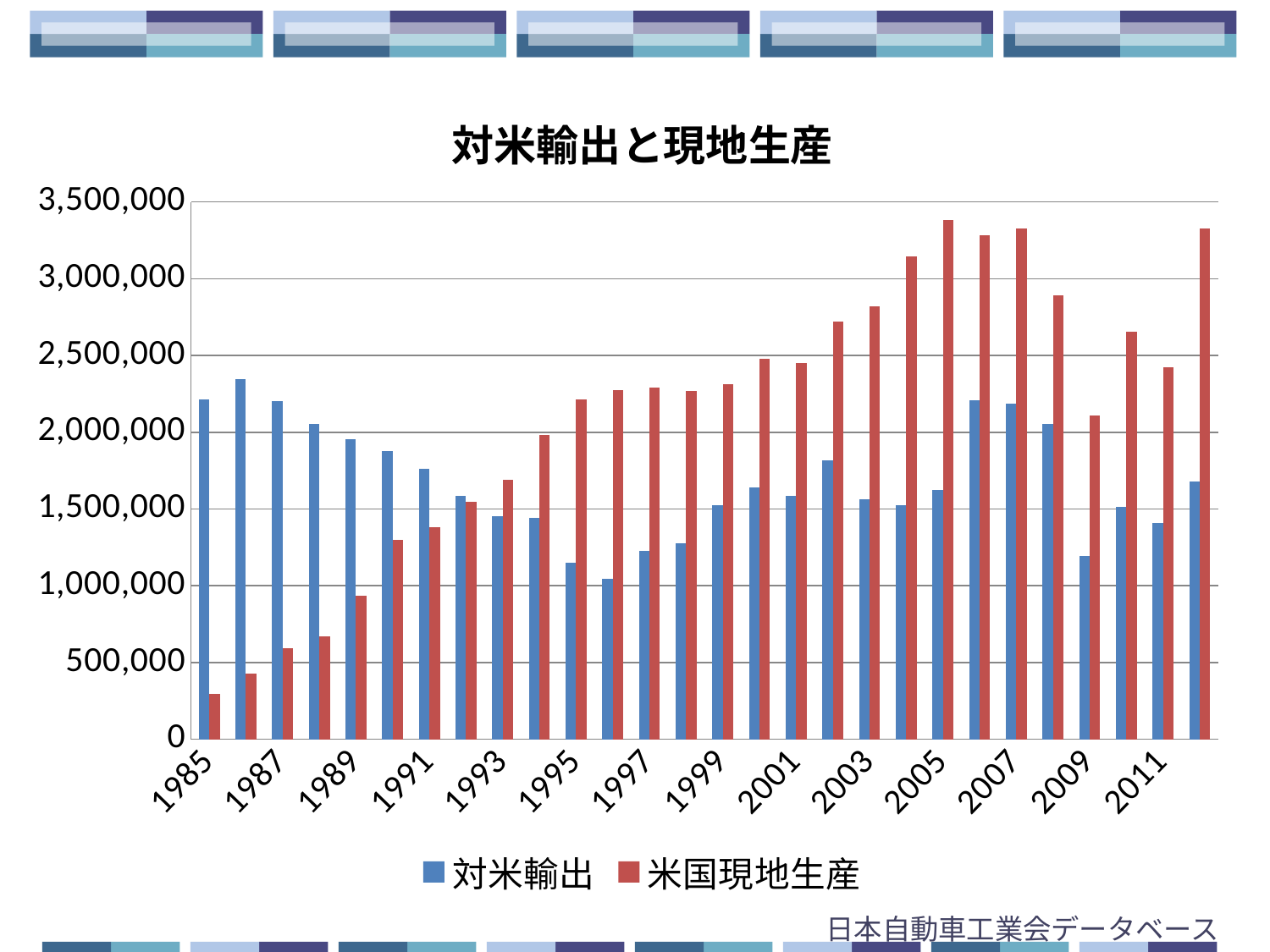
Is the value of 対米輸出 in 2009 greater or less than 1,500,000? less Does 米国現地生産 generally rise or fall from 1985 to 2005? rise Is the value of 米国現地生産 in 2005 greater or less than 3,000,000? greater In 2003, which is larger, 対米輸出 or 米国現地生産? 米国現地生産 Is the value of 米国現地生産 in 1985 greater or less than 500,000? less In 1985, which is larger, 対米輸出 or 米国現地生産? 対米輸出 What is the title of the chart? 対米輸出と現地生産 How many series does the legend list? 2 In which year is 対米輸出 highest? 1986 Which series is shown in red? 米国現地生産 In which year is 米国現地生産 lowest? 1985 What kind of chart is shown on the slide? bar chart